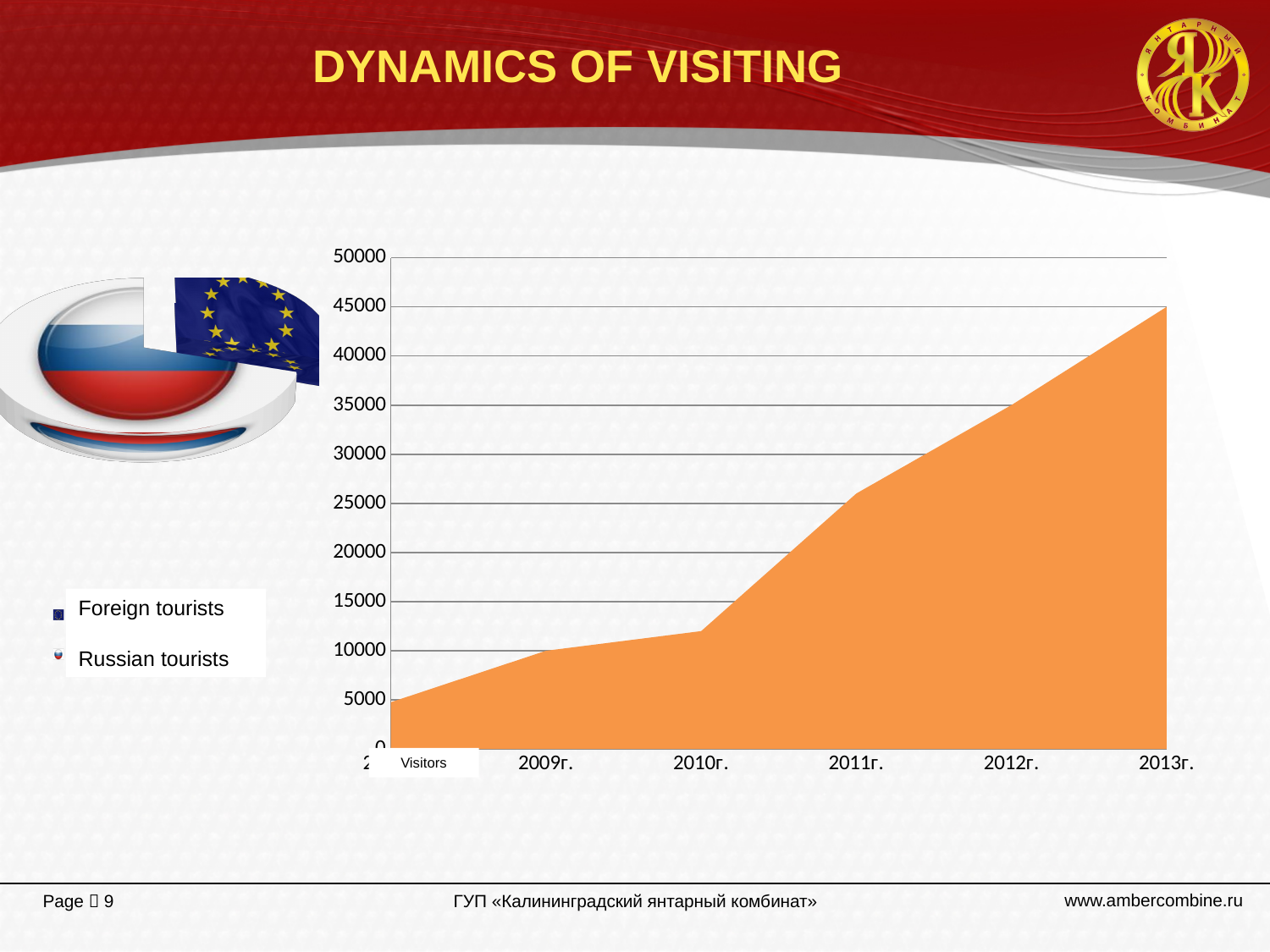
Is the value for 2012г. greater or less than 30000? greater What kind of chart is shown on the slide? area chart Which is larger, the value for 2011г. or the value for 2010г.? 2011г. Is the value for 2010г. greater or less than 15000? less Do the values rise or fall from 2009г. to 2013г.? rise Which two tourist groups are named in the legend next to the chart? Foreign tourists and Russian tourists Which year has the highest value in the chart? 2013г. What is the highest value shown on the vertical axis? 50000 Is the value for 2011г. greater or less than 20000? greater What is the title of the slide containing the chart? DYNAMICS OF VISITING